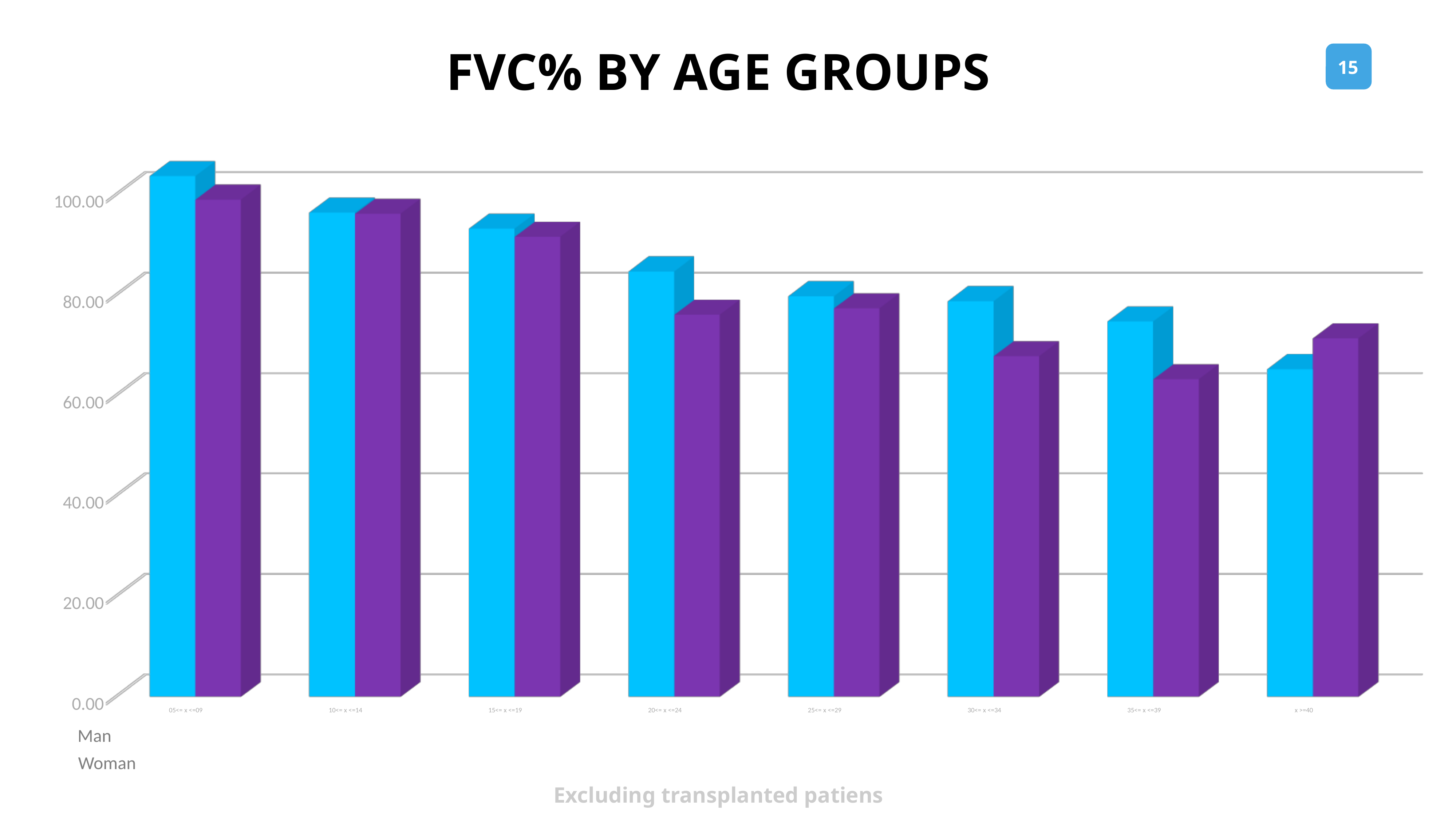
For the age group x >=40, which is larger, Man or Woman? Woman Do the Man values rise or fall as age groups increase along the x axis? Fall Which age group has the highest value for Man? 05<= x <=09 What is the title of the chart? FVC% BY AGE GROUPS What kind of chart is shown on the slide? Bar chart How many series does the legend list? 2 Which age group has the lowest value for Man? x >=40 Is the value for Man in the age group 20<= x <=24 greater or less than 80? greater How many age groups are shown on the x axis? 8 Is the value for Woman in the age group 20<= x <=24 greater or less than 80? less For the age group 20<= x <=24, which is larger, Man or Woman? Man Which age group has the lowest value for Woman? 35<= x <=39